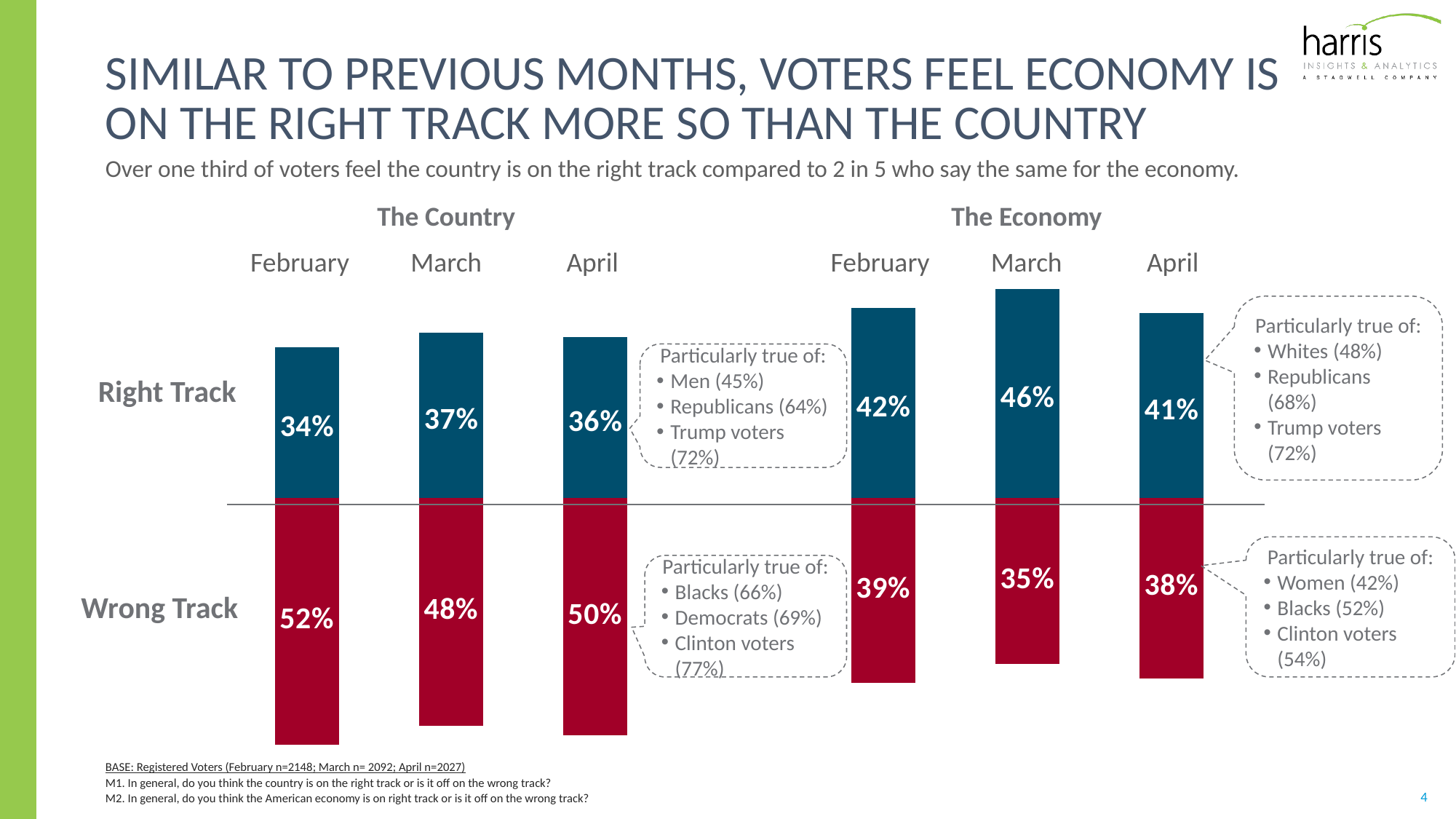
In The Economy chart, does the Wrong Track value rise or fall from February to March? Fall In The Country chart, what is the difference between the Wrong Track values for February and March? 4 percentage points In The Economy chart, what percentage of voters said Wrong Track in April? 38% In The Country chart, what percentage of voters said Right Track in March? 37% In The Country chart, which month has the lowest Wrong Track value? March In The Country chart, what colour are the Wrong Track bars? Red Which is larger: the April Right Track value for The Country or the April Right Track value for The Economy? The Economy In The Economy chart, what is the difference between the Right Track and Wrong Track values for February? 3 percentage points How many months are shown in The Country chart? 3 What type of chart is used to show The Economy data? Bar chart In The Economy chart, which month has the highest Right Track value? March In The Country chart, what is the Wrong Track value for February? 52%